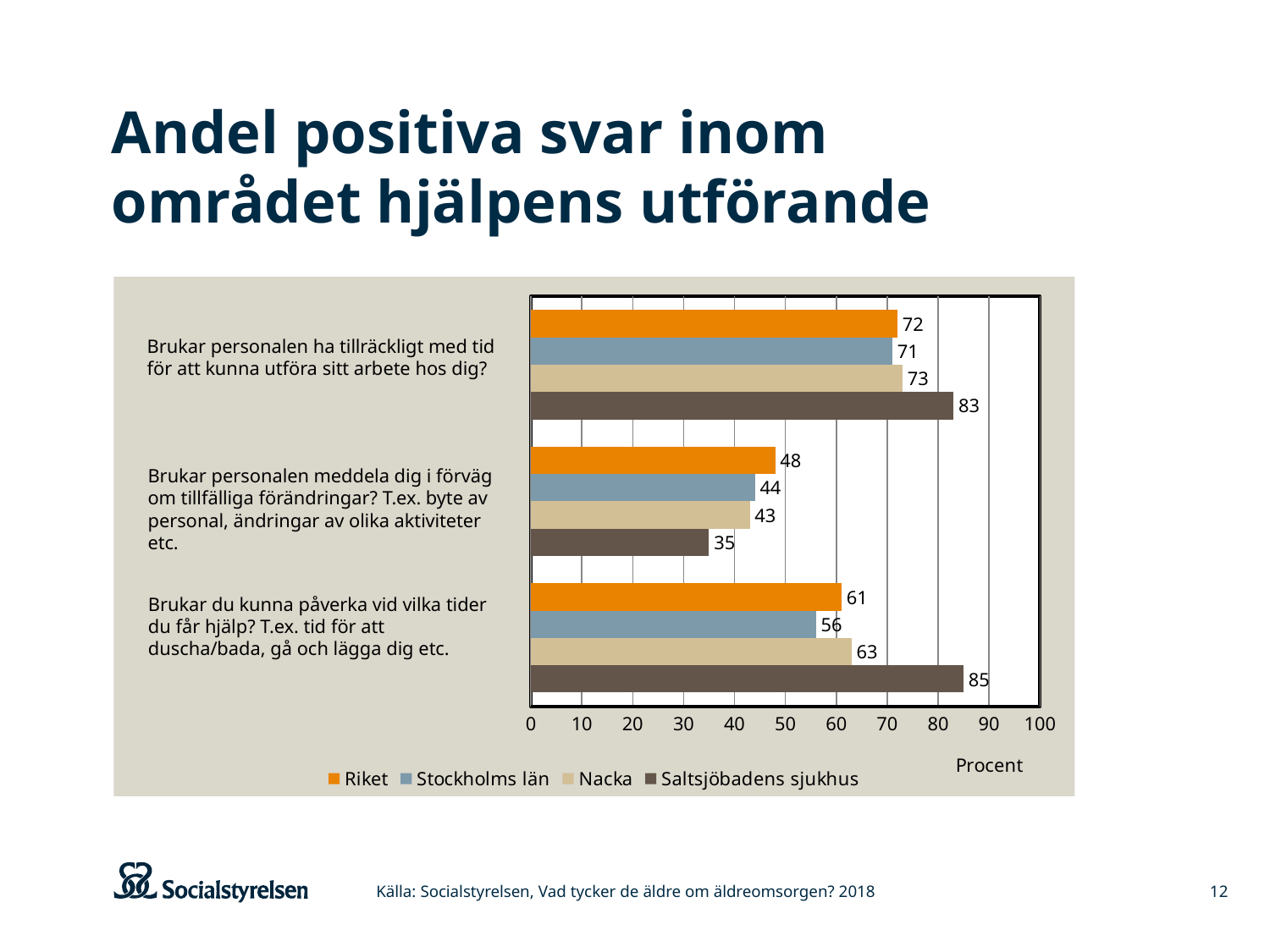
How many series does the legend list? 4 Which series has the lowest value on the question "Brukar personalen meddela dig i förväg om tillfälliga förändringar?"? Saltsjöbadens sjukhus What unit is shown on the horizontal axis of the chart? Procent What kind of chart is shown on the slide? Bar chart How many questions (categories) are shown on the chart? 3 What is the value for Nacka on the question "Brukar du kunna påverka vid vilka tider du får hjälp?"? 63 What is the difference between Saltsjöbadens sjukhus and Riket on the question "Brukar du kunna påverka vid vilka tider du får hjälp?"? 24 Which is larger on the question "Brukar personalen meddela dig i förväg om tillfälliga förändringar?": Riket or Saltsjöbadens sjukhus? Riket What is the value for Saltsjöbadens sjukhus on the question "Brukar personalen ha tillräckligt med tid för att kunna utföra sitt arbete hos dig?"? 83 What is the value for Riket on the question "Brukar personalen meddela dig i förväg om tillfälliga förändringar?"? 48 Which series has the highest value on the question "Brukar du kunna påverka vid vilka tider du får hjälp?"? Saltsjöbadens sjukhus Is the value for Stockholms län on the question "Brukar du kunna påverka vid vilka tider du får hjälp?" greater or less than 60? less